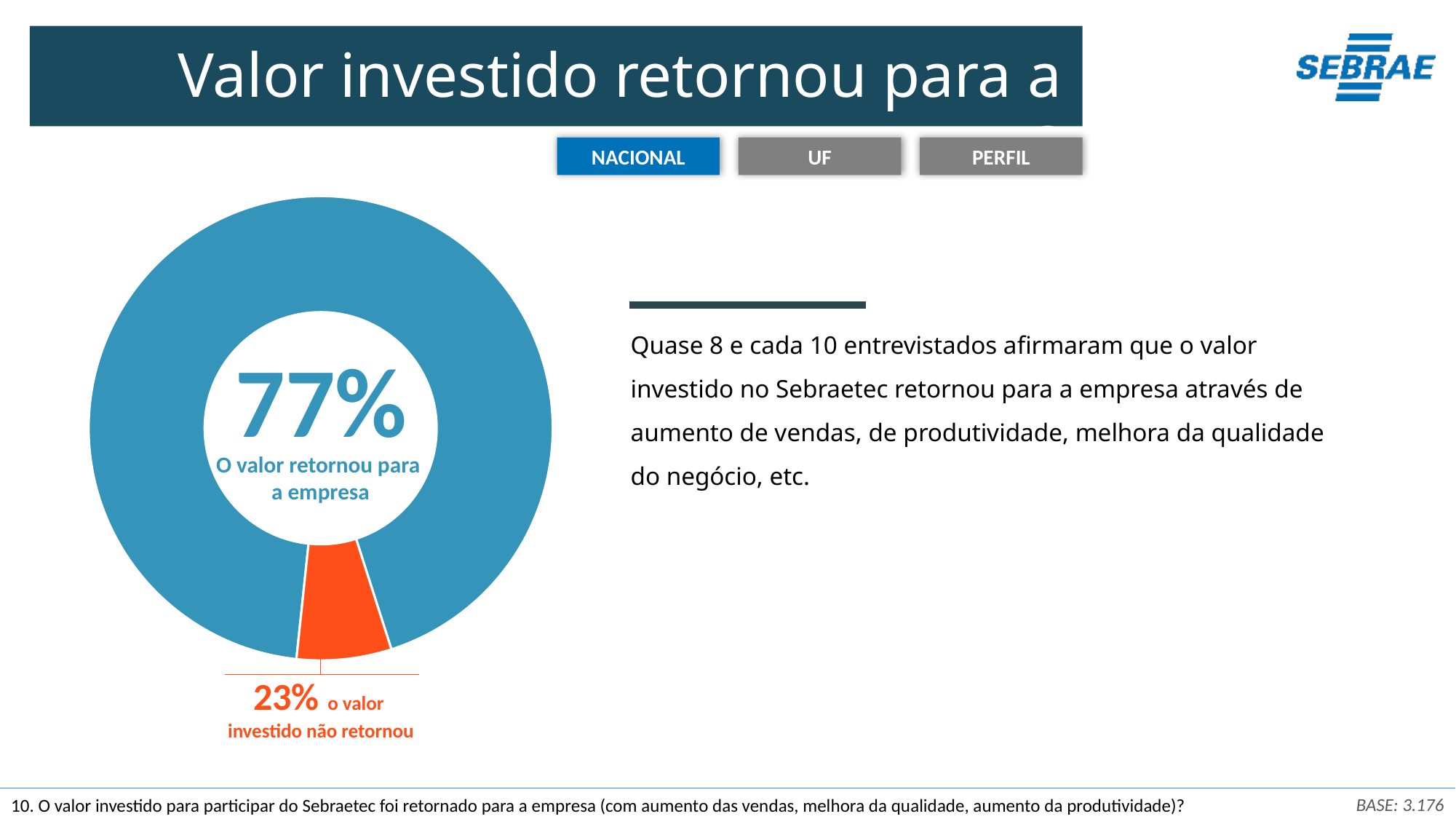
Which category has the smallest share of the chart? o valor investido não retornou How many categories does the chart show? 2 What is the difference in percentage points between the share that returned and the share that did not return? 54 What is the total of the two percentages shown in the chart? 100% What percentage of respondents said the invested value returned to the company ("O valor retornou para a empresa")? 77% What colour is the slice for "o valor investido não retornou"? Orange Which is larger: the share for "O valor retornou para a empresa" or the share for "o valor investido não retornou"? O valor retornou para a empresa What kind of chart is shown on the slide? Pie chart (donut) What percentage of respondents said the invested value did not return ("o valor investido não retornou")? 23% What colour is the slice for "O valor retornou para a empresa"? Blue Which category has the largest share of the chart? O valor retornou para a empresa